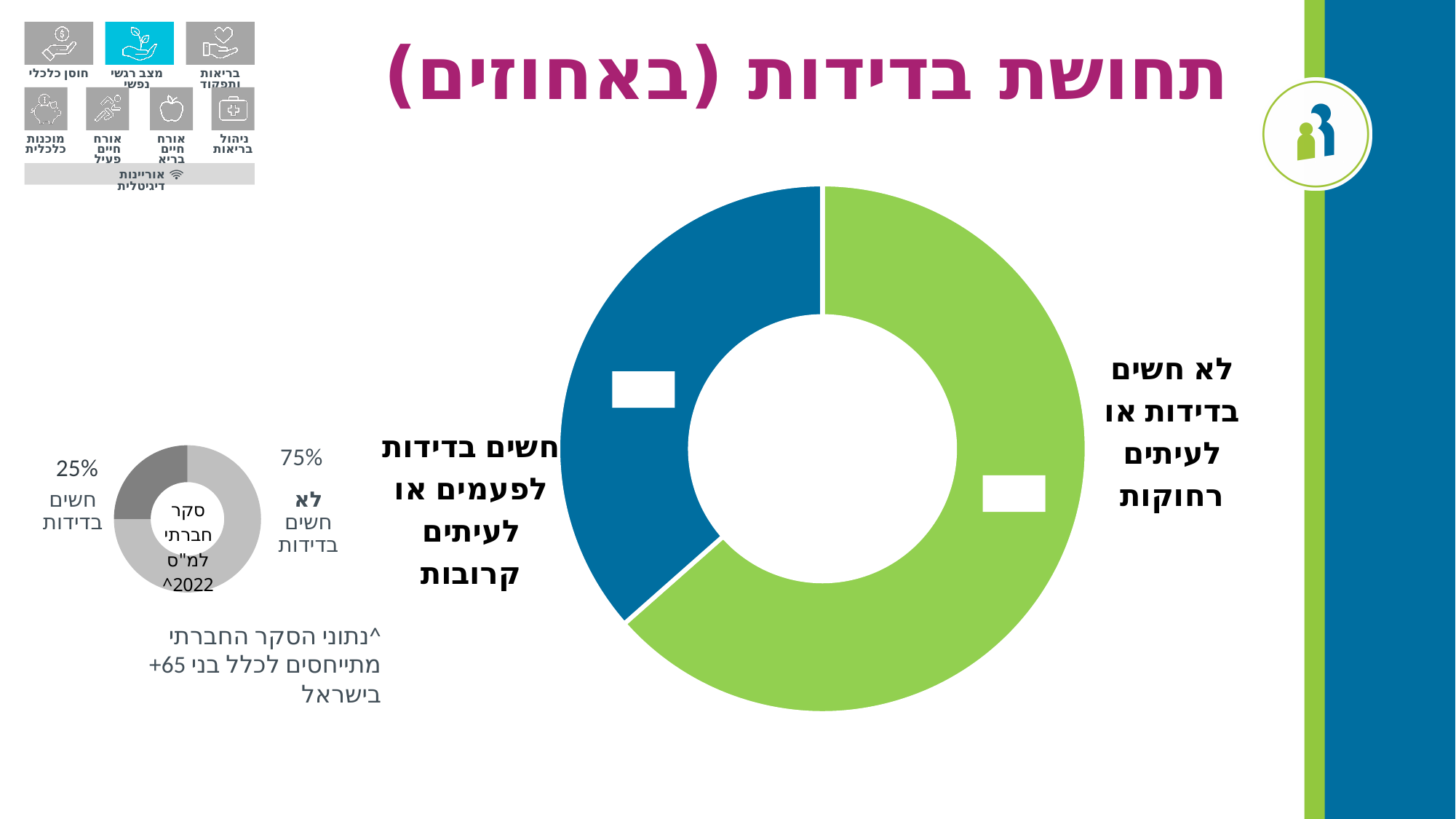
What kind of chart is the large chart in the centre of the slide (תחושת בדידות)? Donut (pie) chart In the small chart on the left (סקר חברתי למ"ס 2022), what percentage is shown for חשים בדידות? 25% In the large chart in the centre (תחושת בדידות), which slice is larger: לא חשים בדידות או לעיתים רחוקות or חשים בדידות לפעמים או לעיתים קרובות? לא חשים בדידות או לעיתים רחוקות In the small chart on the left (סקר חברתי למ"ס 2022), which category has the smallest share? חשים בדידות In the small chart on the left (סקר חברתי למ"ס 2022), how many slices does the chart have? 2 In the small chart on the left (סקר חברתי למ"ס 2022), which category has the largest share? לא חשים בדידות In the large chart in the centre (תחושת בדידות), how many slices does the chart have? 2 What is the title of the large chart in the centre of the slide? תחושת בדידות (באחוזים) In the large chart in the centre (תחושת בדידות), what colour is the slice for חשים בדידות לפעמים או לעיתים קרובות? Blue What kind of chart is the small chart on the left (סקר חברתי למ"ס 2022)? Donut (pie) chart In the small chart on the left (סקר חברתי למ"ס 2022), what is the difference in percentage points between לא חשים בדידות and חשים בדידות? 50% In the small chart on the left (סקר חברתי למ"ס 2022), what percentage is shown for לא חשים בדידות? 75%